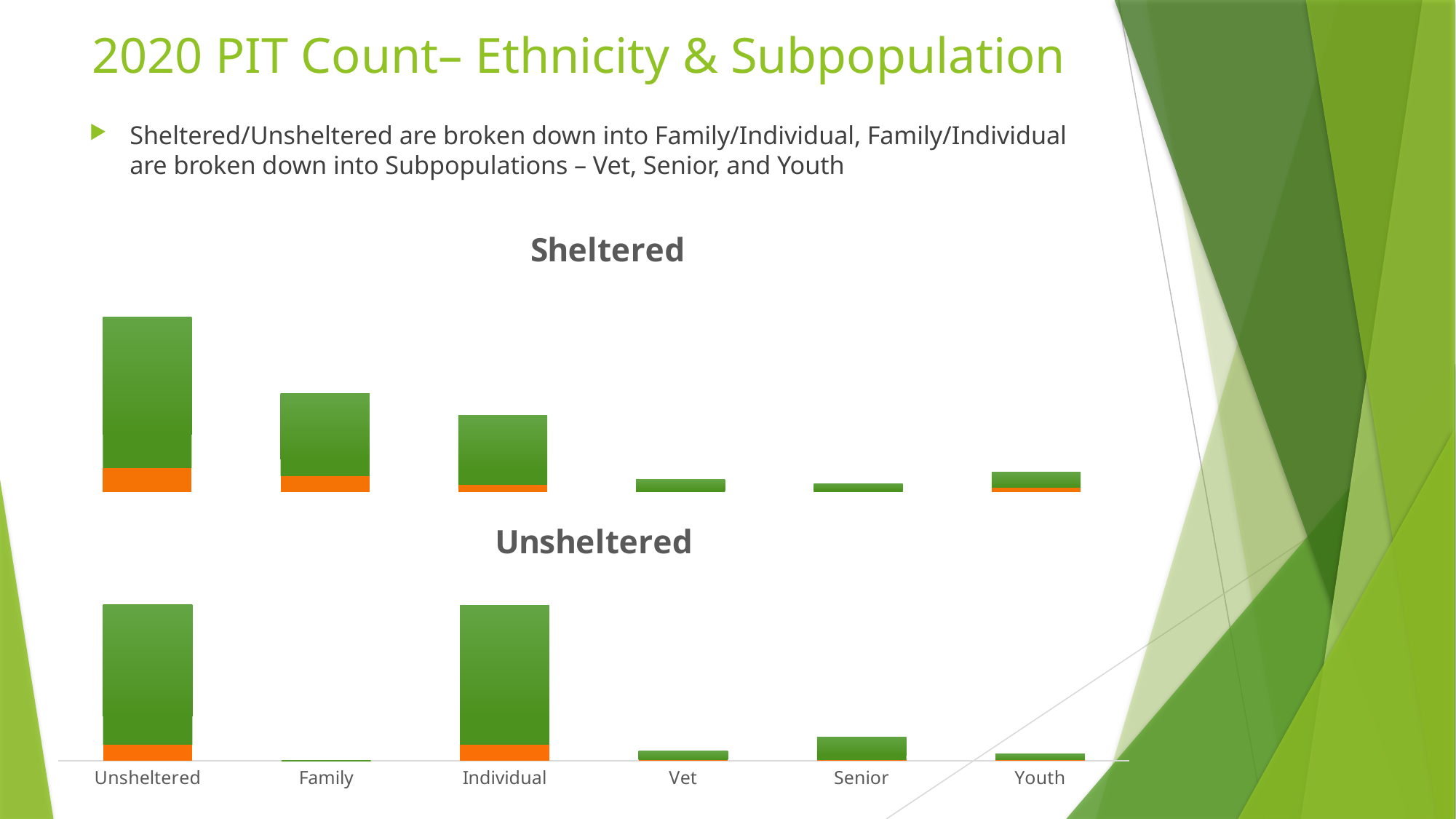
In the Unsheltered chart, which category has the lowest value? Family In the Unsheltered chart, which is larger, Individual or Vet? Individual How many bars are plotted in the Sheltered chart? 6 In the Unsheltered chart, which is larger, Senior or Youth? Senior In the Unsheltered chart, which is larger, Senior or Vet? Senior What kind of chart is the Sheltered chart? Bar chart What two colours are used for the stacked segments in the bars? Green and orange What kind of chart is the Unsheltered chart? Bar chart How many categories are shown on the x axis of the Unsheltered chart? 6 What are the titles of the two charts on the slide? Sheltered and Unsheltered